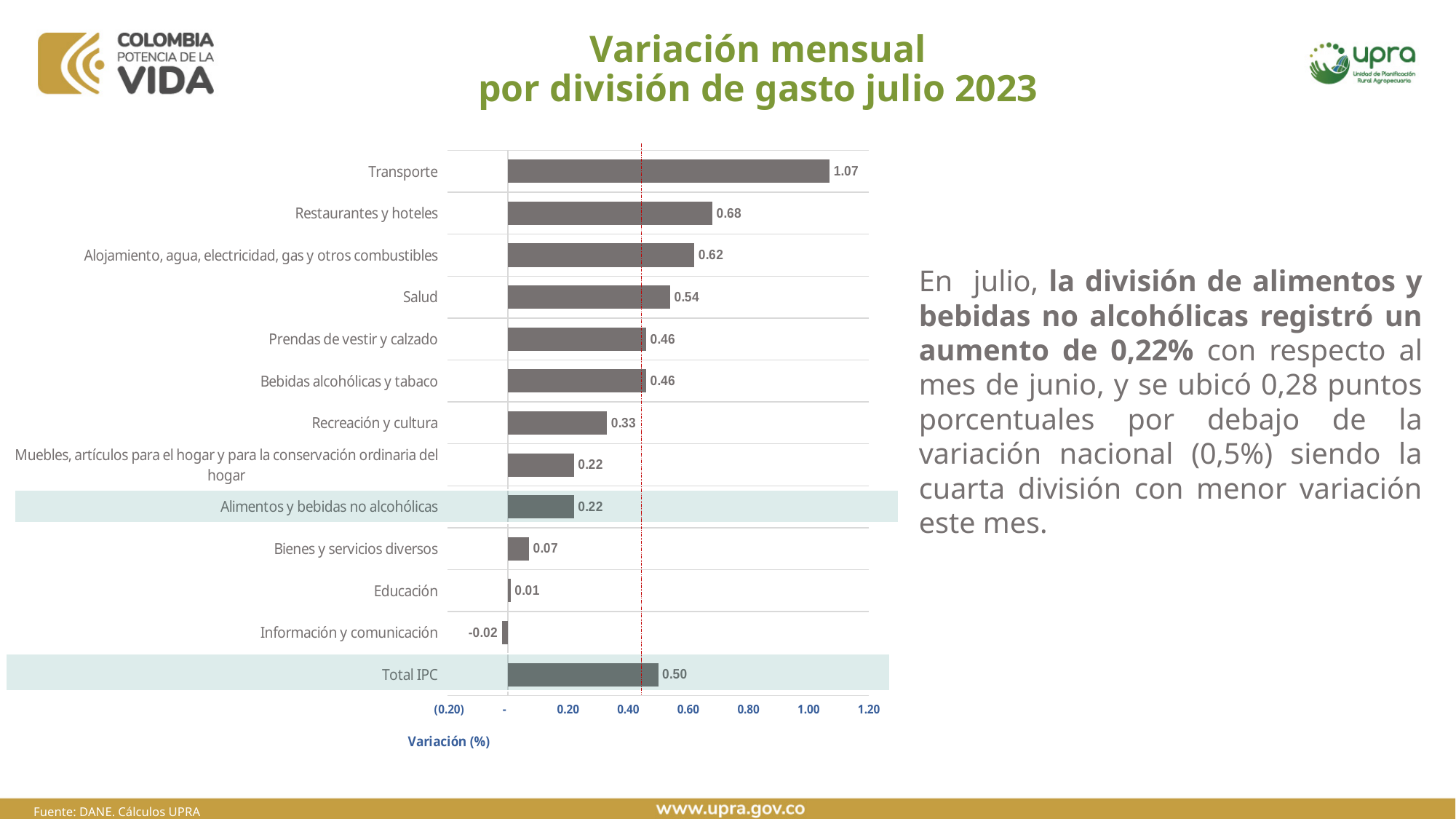
What is the value for Información y comunicación? -0.02 Which category has the lowest value? Información y comunicación What kind of chart is shown on the slide? bar chart What is the label of the horizontal axis? Variación (%) Which is larger, the value for Salud or the value for Recreación y cultura? Salud Is the value for Alojamiento, agua, electricidad, gas y otros combustibles greater or less than 0.40? greater What is the difference between the values for Transporte and Restaurantes y hoteles? 0.39 How many categories are shown on the chart? 13 Which category has the highest value? Transporte What is the value for Total IPC? 0.50 What is the value for Alimentos y bebidas no alcohólicas? 0.22 What is the value for Transporte? 1.07